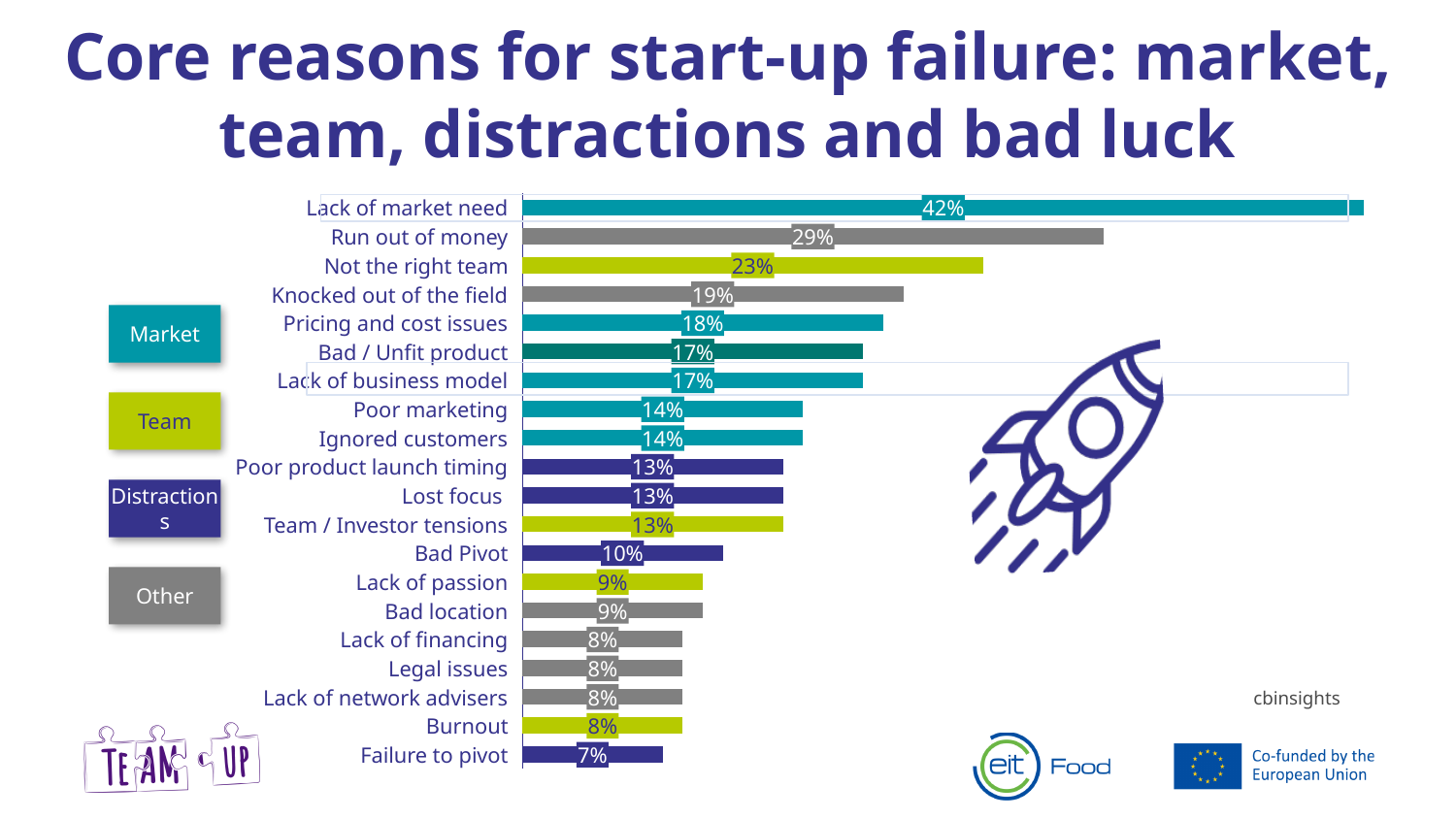
Which is larger: the value for 'Pricing and cost issues' or the value for 'Poor marketing'? Pricing and cost issues What is the value for 'Bad Pivot'? 10% Which reason for start-up failure has the highest percentage? Lack of market need Which reason for start-up failure has the lowest percentage? Failure to pivot What type of chart is used on this slide? Bar chart What is the value shown for 'Run out of money'? 29% How many reasons for start-up failure are plotted in the chart? 20 What is the difference between the percentages for 'Lack of market need' and 'Run out of money'? 13% What percentage of start-ups failed due to lack of market need? 42% Which colour key group is shown in yellow-green? Team How many category groups are listed in the colour key beside the chart? 4 What percentage is shown for 'Not the right team'? 23%